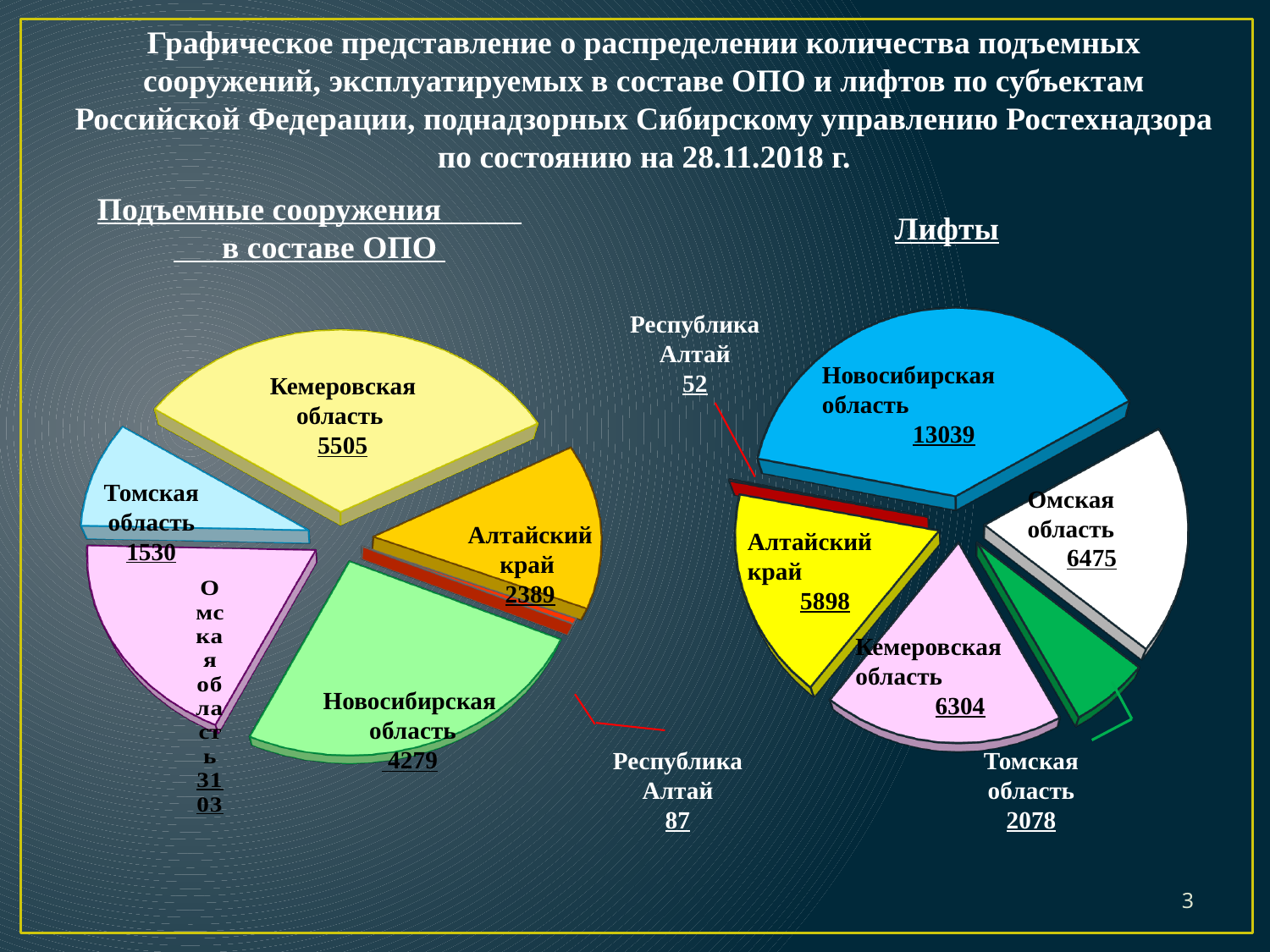
In the "Подъемные сооружения в составе ОПО" chart, what is the value for Кемеровская область? 5505 In the "Подъемные сооружения в составе ОПО" chart, what is the value for Республика Алтай? 87 What kind of charts are shown on the slide? Pie charts In the "Подъемные сооружения в составе ОПО" chart, what is the difference between Новосибирская область and Алтайский край? 1890 In the "Лифты" chart, what is the difference between Омская область and Алтайский край? 577 In the "Лифты" chart, which region has the largest value? Новосибирская область In the "Лифты" chart, what is the value for Новосибирская область? 13039 In the "Подъемные сооружения в составе ОПО" chart, which region has the smallest value? Республика Алтай In the "Подъемные сооружения в составе ОПО" chart, which region has the largest value? Кемеровская область In the "Лифты" chart, which is larger: Омская область or Кемеровская область? Омская область In the "Лифты" chart, what is the value for Томская область? 2078 How many regions are shown in the "Лифты" chart? 6